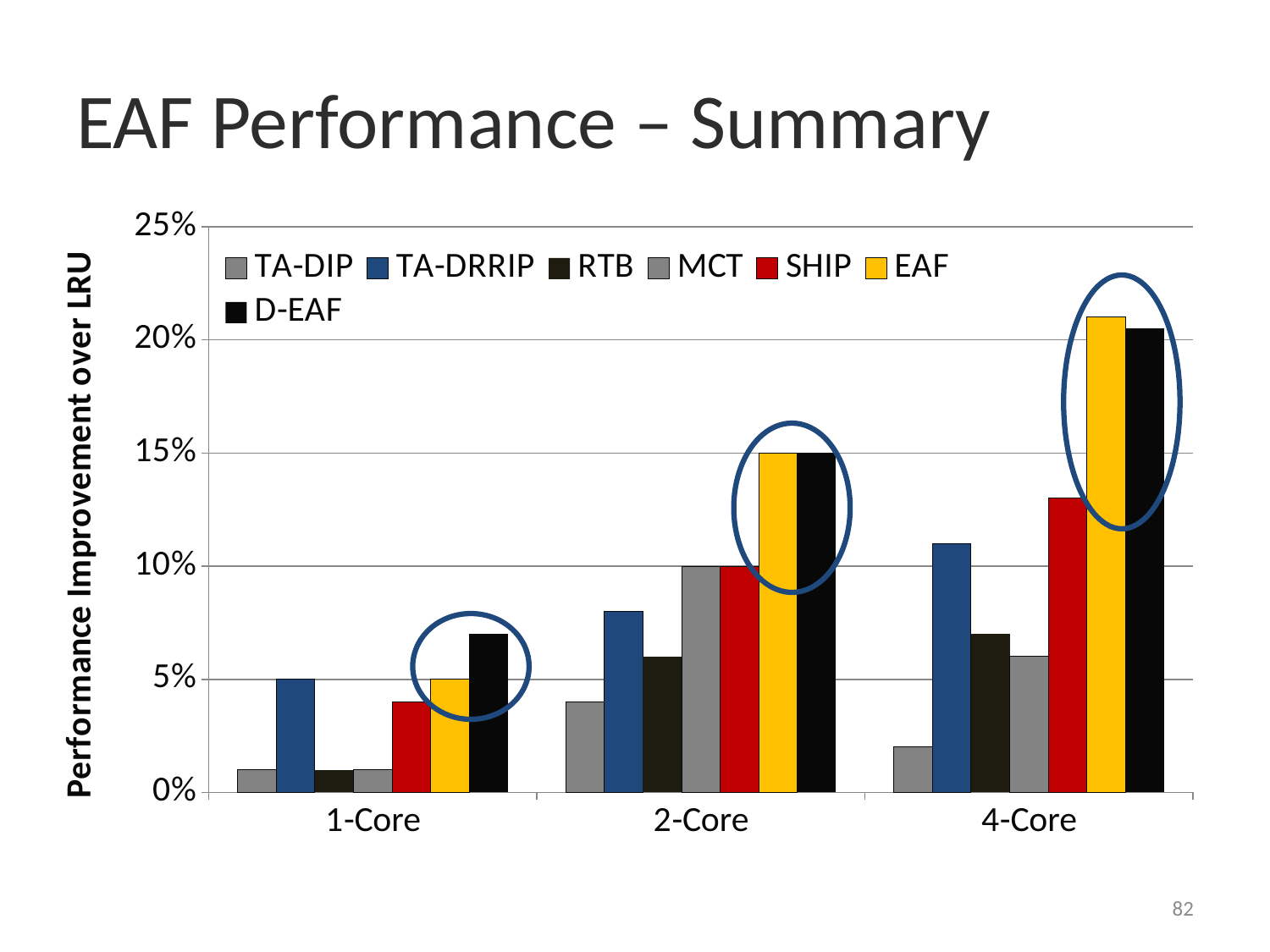
Is the value for TA-DRRIP in the 2-Core category greater or less than 10%? less What is the value for TA-DRRIP in the 1-Core category? 5% What kind of chart is shown on the slide? bar chart What is the value for MCT in the 2-Core category? 10% In the 4-Core category, which is larger, SHIP or TA-DRRIP? SHIP Is the value for EAF in the 4-Core category greater or less than 20%? greater How many categories are shown on the x axis? 3 Does the value for EAF rise or fall from 1-Core to 4-Core? rise Which series has the lowest value in the 2-Core category? TA-DIP Is the value for TA-DIP in the 4-Core category greater or less than 5%? less How many series does the legend list? 7 What is the value for EAF in the 2-Core category? 15%